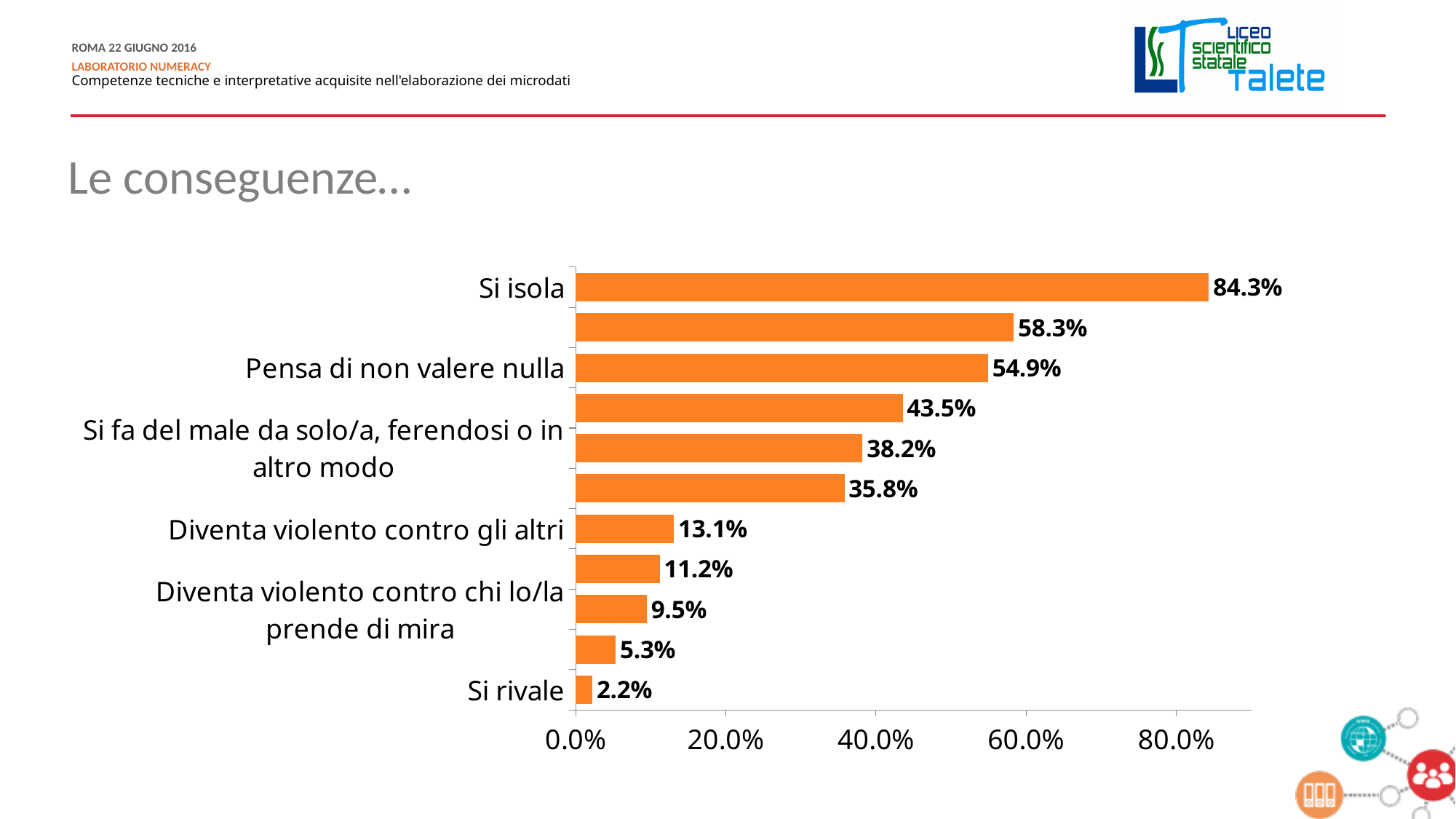
What is the value for "Diventa violento contro gli altri"? 13.1% What kind of chart is shown on the slide? Bar chart How many bars are plotted in the chart? 11 What is the value for "Si isola"? 84.3% What is the value for "Pensa di non valere nulla"? 54.9% Which category has the lowest value? Si rivale Which category has the highest value? Si isola Which is larger, the value for "Diventa violento contro gli altri" or the value for "Diventa violento contro chi lo/la prende di mira"? Diventa violento contro gli altri What is the value for "Si rivale"? 2.2% What is the value for "Si fa del male da solo/a, ferendosi o in altro modo"? 38.2% What is the value for "Diventa violento contro chi lo/la prende di mira"? 9.5% What is the difference between the values for "Si isola" and "Pensa di non valere nulla"? 29.4%